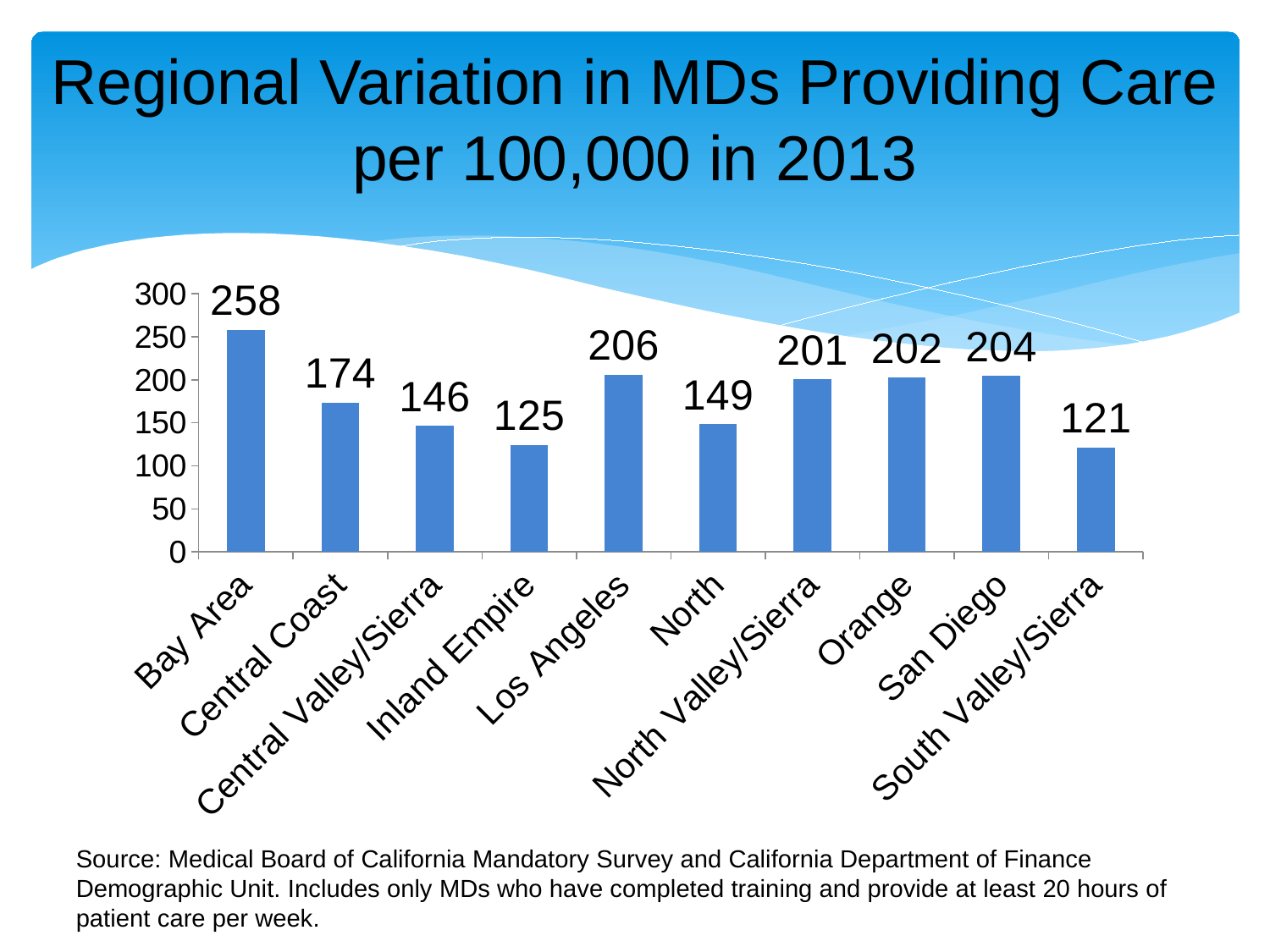
Is the value for San Diego greater or less than 200? greater Which region has the highest value? Bay Area What is the value for North Valley/Sierra? 201 What is the title of the chart on the slide? Regional Variation in MDs Providing Care per 100,000 in 2013 What kind of chart is shown on the slide? bar chart What is the value for Bay Area? 258 What is the difference between the values for Bay Area and Los Angeles? 52 What is the value for Inland Empire? 125 Which is larger, the value for Central Valley/Sierra or the value for Inland Empire? Central Valley/Sierra Which region has the lowest value? South Valley/Sierra What is the difference between the values for Central Coast and North? 25 How many regions are shown on the chart? 10